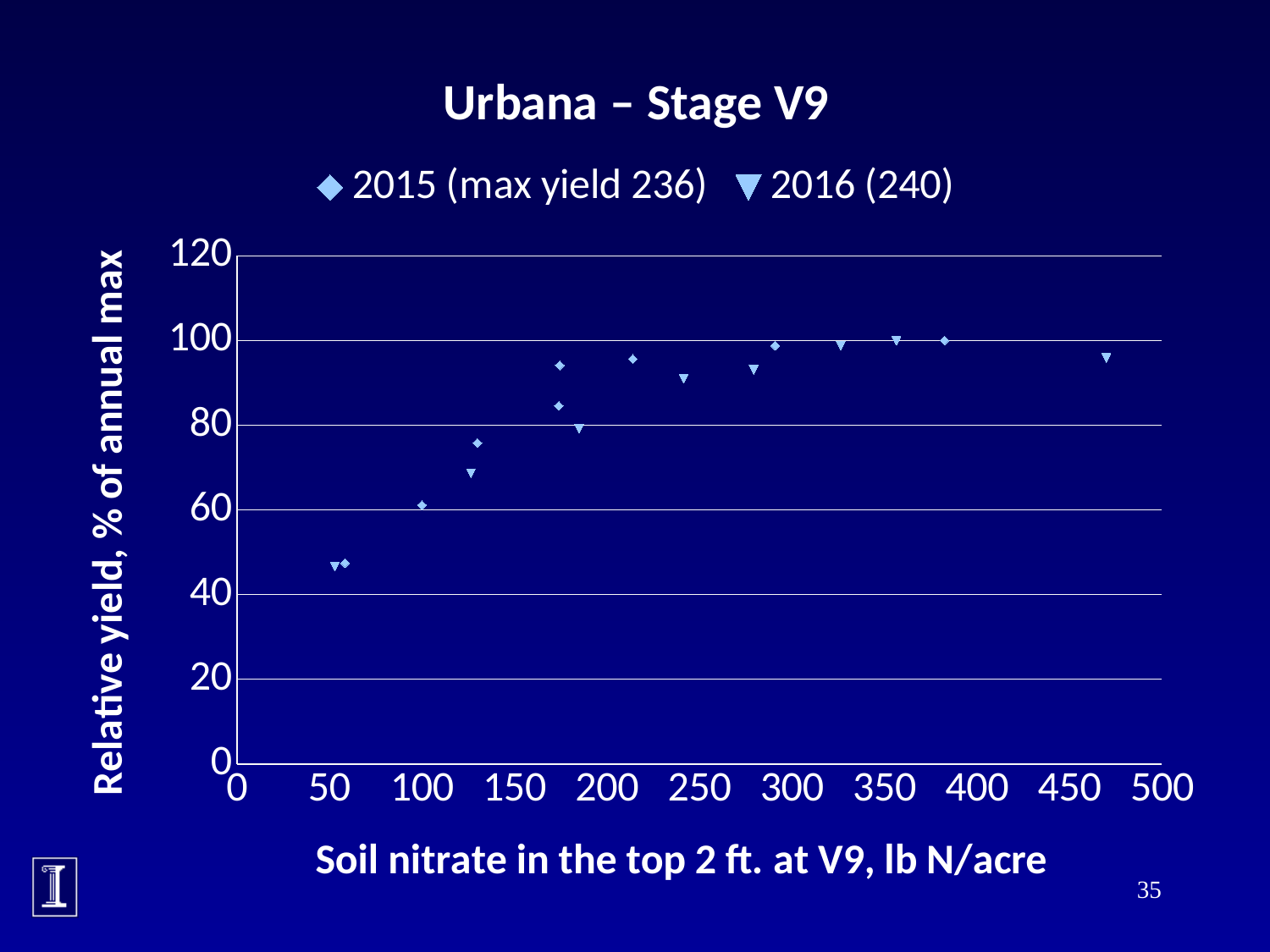
Is the relative yield for the 2015 points near 50 lb N/acre greater or less than 60? less What is the title of the chart? Urbana – Stage V9 What is the highest value shown on the y axis? 120 Is the relative yield for the 2015 point near 215 lb N/acre greater or less than 80? greater Is the relative yield for the 2016 point near 470 lb N/acre greater or less than 100? less How many series does the legend list? 2 What is the label of the x axis? Soil nitrate in the top 2 ft. at V9, lb N/acre Do the relative yield values generally rise or fall as soil nitrate increases along the x axis? rise What kind of chart is shown on the slide? scatter chart